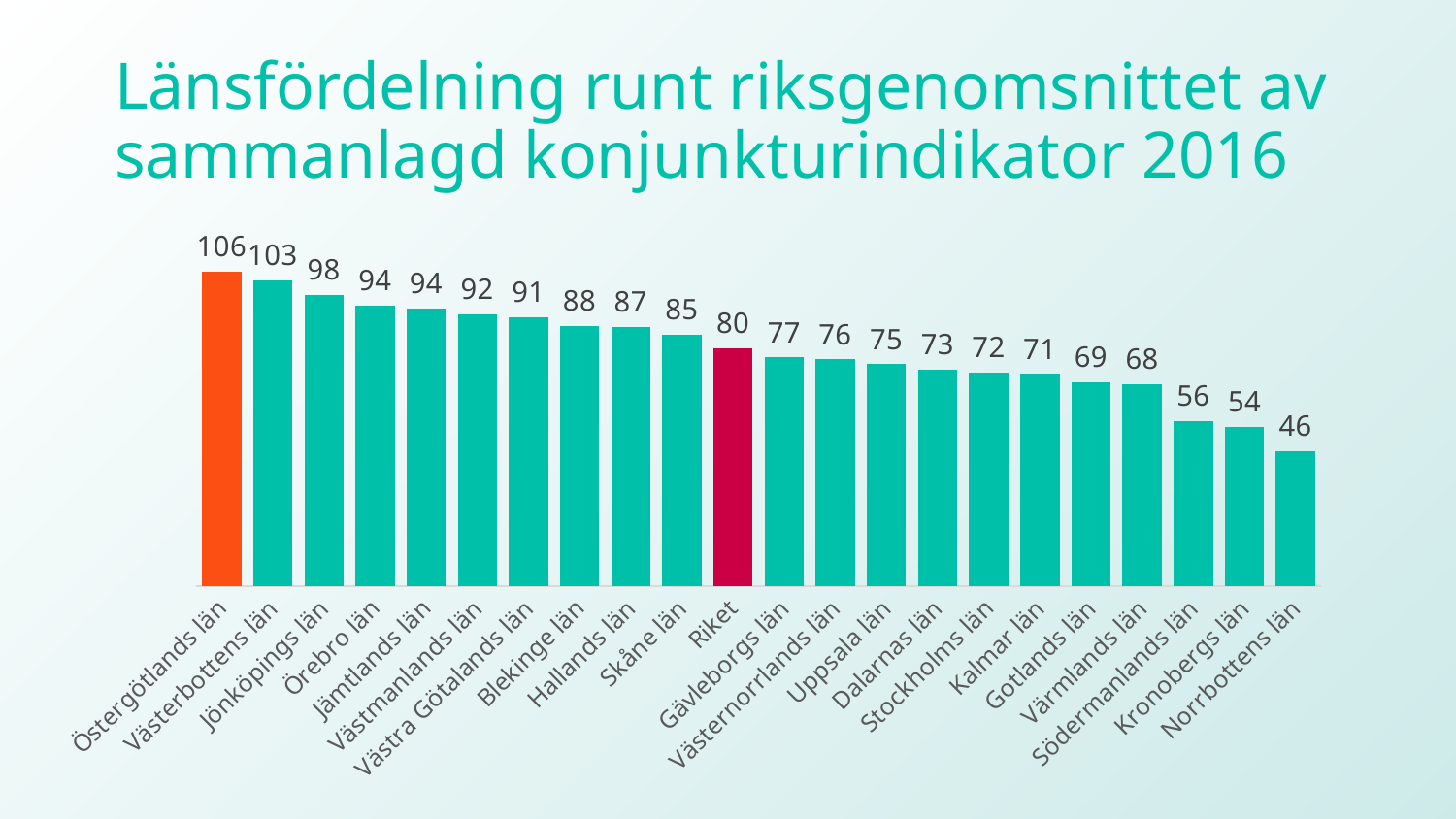
What is the difference between the values for Riket and Skåne län? 5 What is the difference between the values for Östergötlands län and Norrbottens län? 60 Which category has the lowest value? Norrbottens län Which category has the highest value? Östergötlands län What is the value for Blekinge län? 88 What is the value for Stockholms län? 72 Which is larger, the value for Uppsala län or the value for Gotlands län? Uppsala län What kind of chart is shown on the slide? Bar chart Do the values rise or fall from left to right along the x axis? Fall How many bars are shown in the chart? 22 What is the value for Riket? 80 Which bar is coloured orange? Östergötlands län